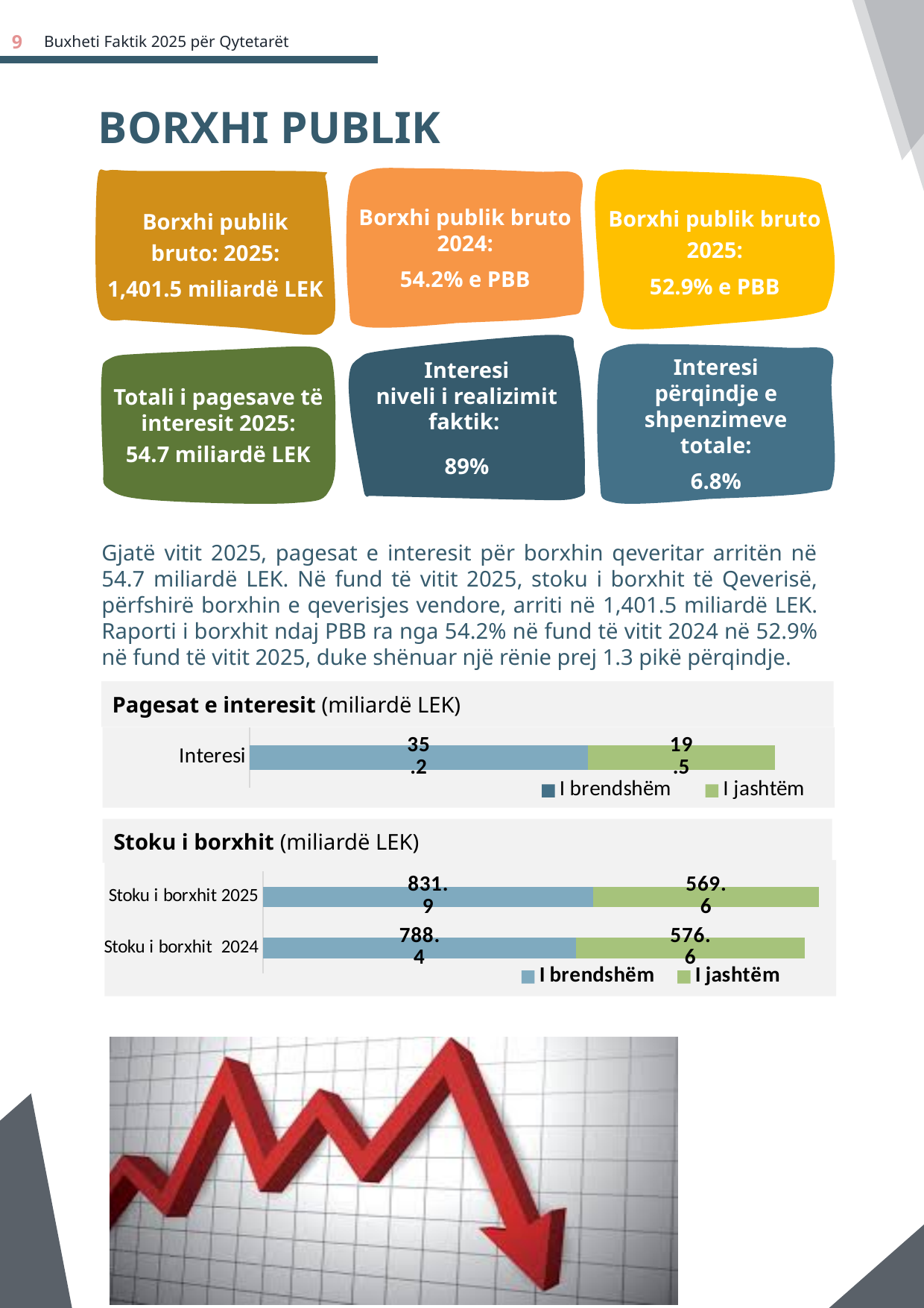
In the 'Stoku i borxhit' chart, how many categories are plotted? 2 In the 'Pagesat e interesit' chart, what is the value for I brendshëm? 35.2 In the 'Pagesat e interesit' chart, what is the total of the stacked bar for Interesi? 54.7 In the 'Stoku i borxhit' chart, what is the total of the stacked bar for Stoku i borxhit 2024? 1,365.0 In the 'Pagesat e interesit' chart, what is the value for I jashtëm? 19.5 In the 'Pagesat e interesit' chart, how many series does the legend list? 2 In the 'Stoku i borxhit' chart, what is the I jashtëm value for Stoku i borxhit 2024? 576.6 What kind of chart is the 'Stoku i borxhit' chart? Stacked bar chart In the 'Stoku i borxhit' chart, what is the total of the stacked bar for Stoku i borxhit 2025? 1,401.5 In the 'Stoku i borxhit' chart, which year has the larger I jashtëm value, 2025 or 2024? 2024 In the 'Stoku i borxhit' chart, what is the I brendshëm value for Stoku i borxhit 2025? 831.9 In the 'Stoku i borxhit' chart, what is the difference between the I brendshëm values for 2025 and 2024? 43.5